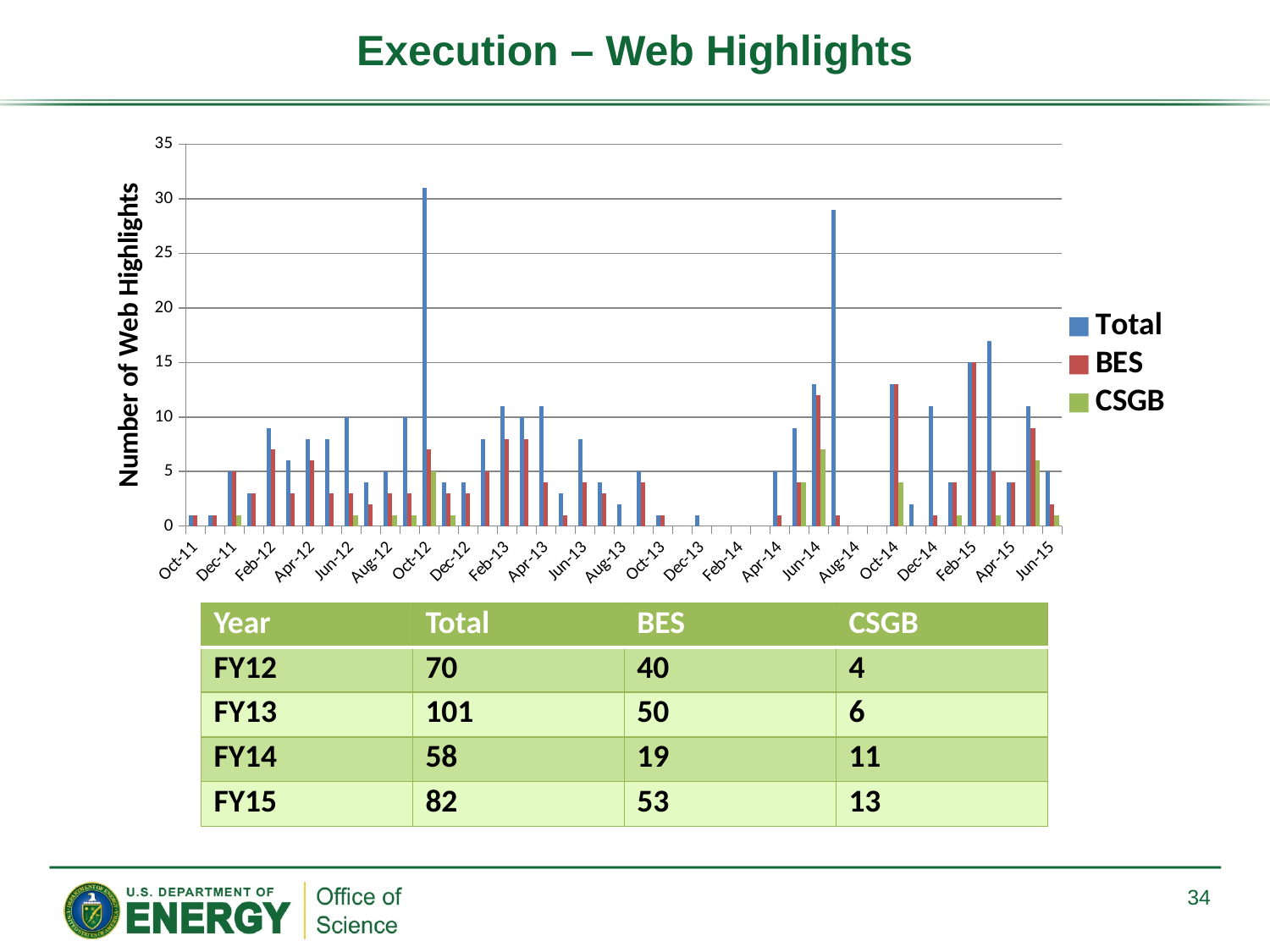
What are the three series named in the chart legend? Total, BES, CSGB Which is larger, the BES value for Oct-14 or the BES value for Oct-12? Oct-14 Is the Total value for Oct-12 greater or less than 25? greater Is the Total value for Dec-14 greater or less than 10? greater Is the BES value for Oct-14 greater or less than 10? greater Which is larger, the Total value for Oct-12 or the Total value for Oct-14? Oct-12 What is the title of the vertical axis of the chart? Number of Web Highlights In which labeled month does the Total series reach its highest value? Oct-12 How many series does the chart legend list? 3 What kind of chart is shown on the slide? bar chart